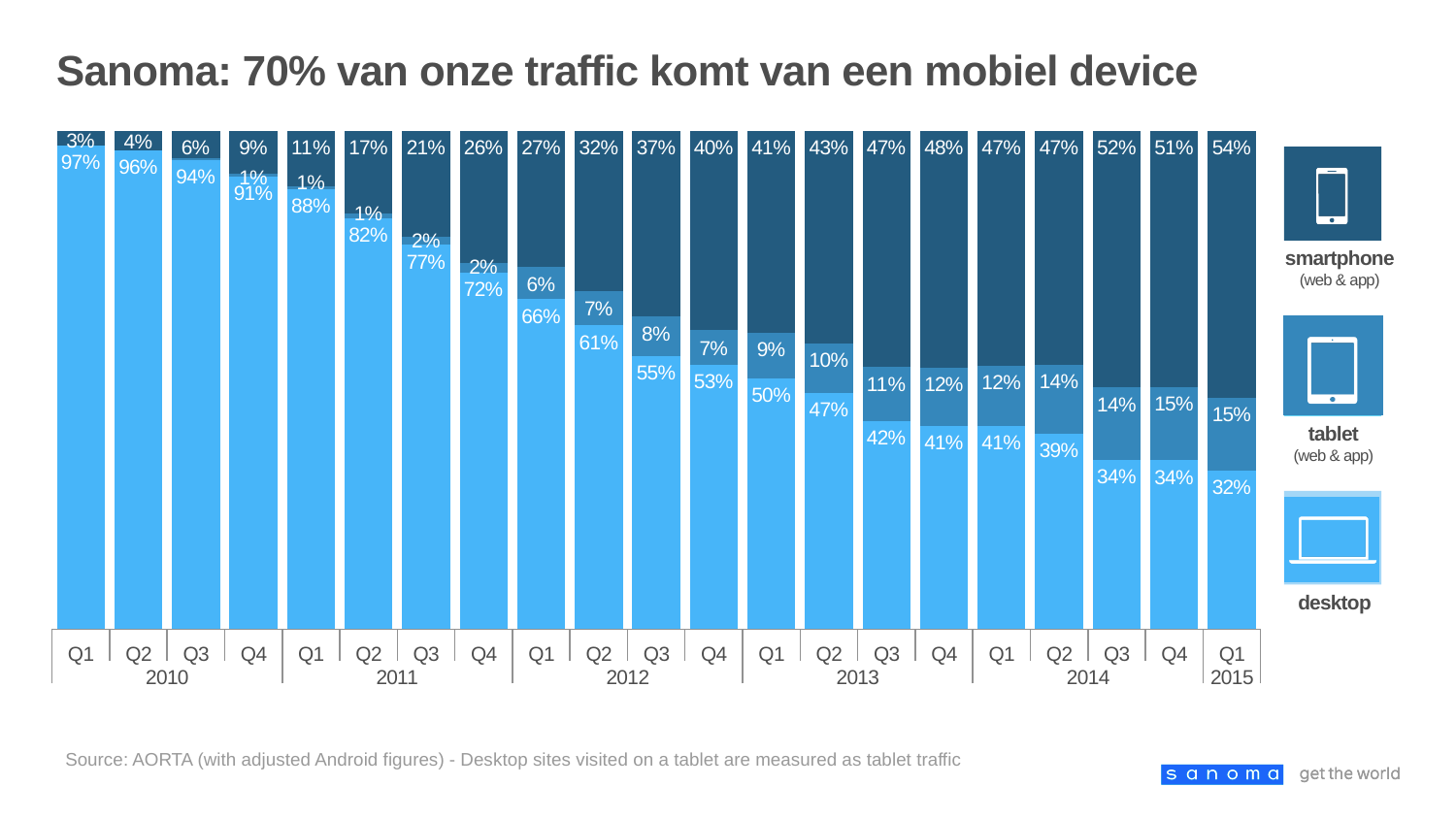
In which quarter was the smartphone share of traffic highest? Q1 2015 What share of traffic came from smartphones in Q1 2015? 54% Does the desktop share of traffic rise or fall from Q1 2010 to Q1 2015? fall Which was larger in Q3 2013: the smartphone share or the desktop share? smartphone In which quarter was the desktop share of traffic lowest? Q1 2015 What share of traffic came from desktop in Q1 2010? 97% What is the difference between the desktop share in Q1 2010 and the desktop share in Q1 2015? 65% What is the total of the three segments in the Q3 2014 bar? 100% What kind of chart is shown on the slide? stacked bar chart What share of traffic came from tablets in Q2 2014? 14% How many quarters are shown on the x axis? 21 How many series (device types) does the chart show? 3